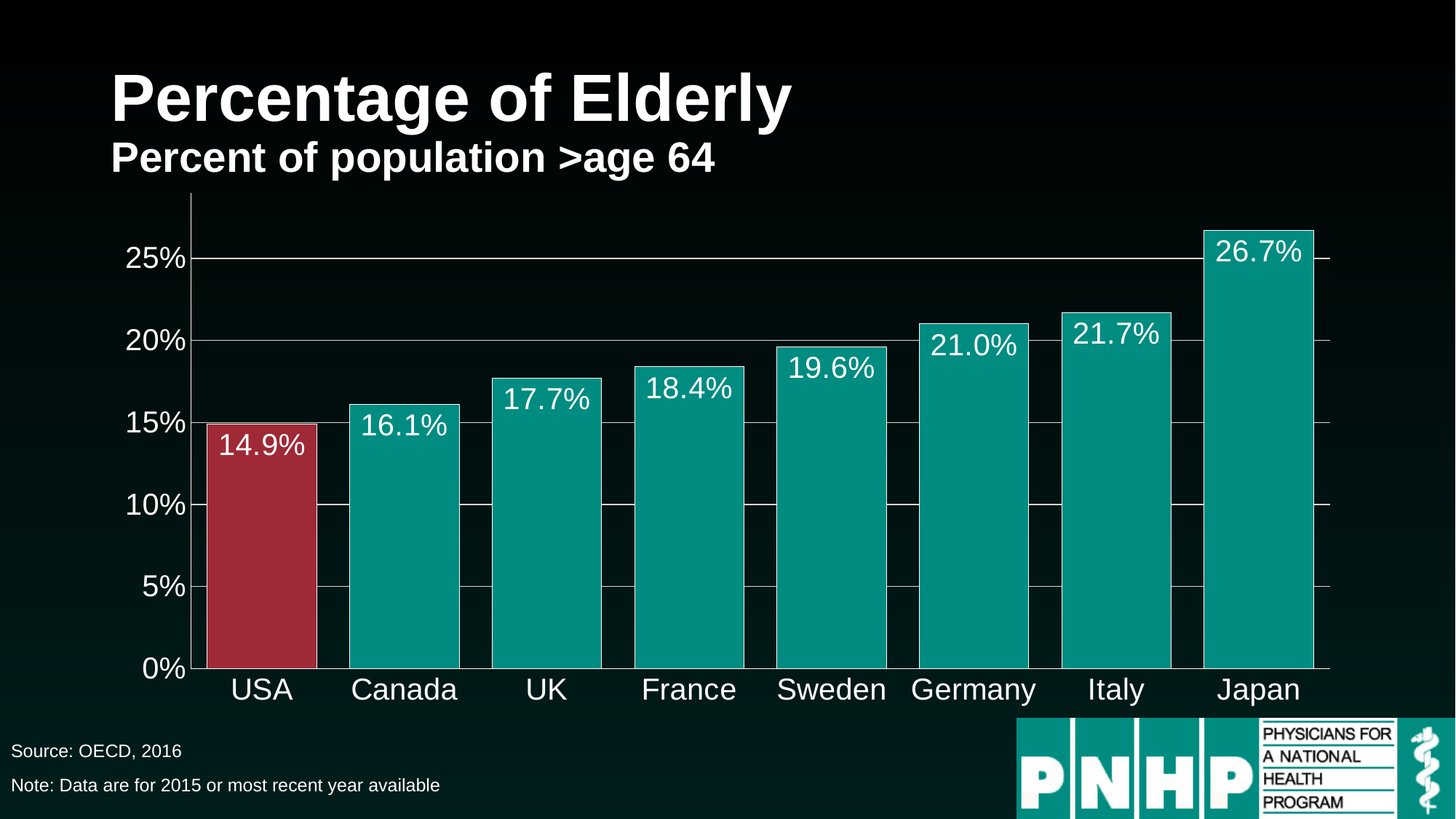
Which bar is coloured differently (red) from the others? USA How many countries are shown in the chart? 8 What kind of chart is shown on the slide? Bar chart Is the value for the UK greater or less than 20%? less What is the percentage of elderly for the USA? 14.9% What is the percentage of elderly for Germany? 21.0% Which country has the lowest percentage of elderly? USA What is the percentage of elderly for Sweden? 19.6% Which has a higher percentage of elderly, France or Canada? France What is the difference in percentage points between Japan and the USA? 11.8 What is the difference in percentage points between Italy and Germany? 0.7 Which country has the highest percentage of elderly? Japan